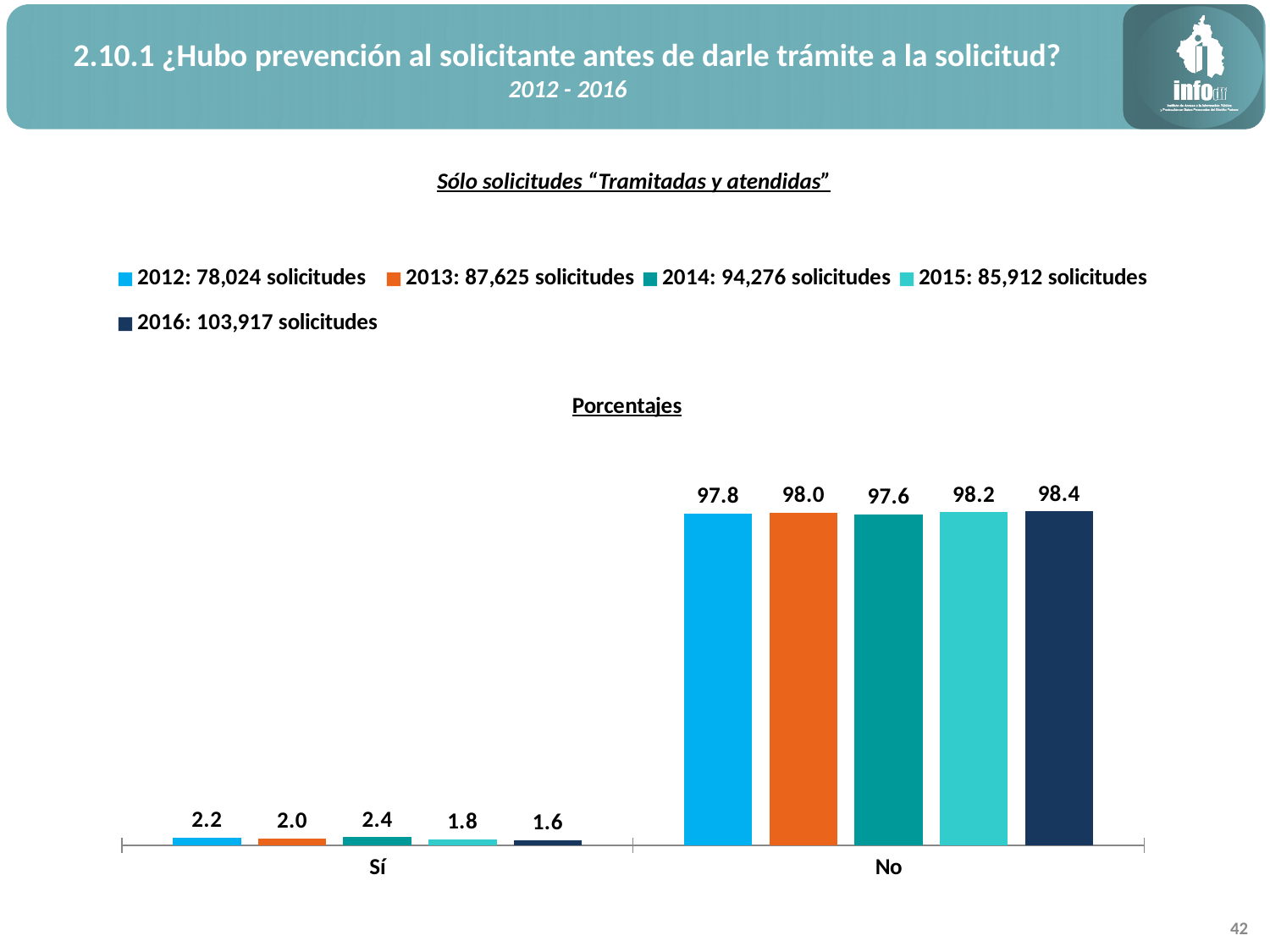
How many series does the legend list? 5 Which is larger in the "Sí" category: the value for 2013 or the value for 2015? 2013 What kind of chart is shown on the slide? Bar chart Which year has the highest value in the "Sí" category? 2014 What is the difference between the 2014 and 2016 values in the "Sí" category? 0.8 What is the value for 2016 in the "No" category? 98.4 According to the legend, how many solicitudes were there in 2016? 103,917 solicitudes What is the value for 2012 in the "Sí" category? 2.2 What is the value for 2014 in the "Sí" category? 2.4 Which year has the lowest value in the "No" category? 2014 What is the difference between the 2016 and 2012 values in the "No" category? 0.6 How many categories are shown on the x axis? 2